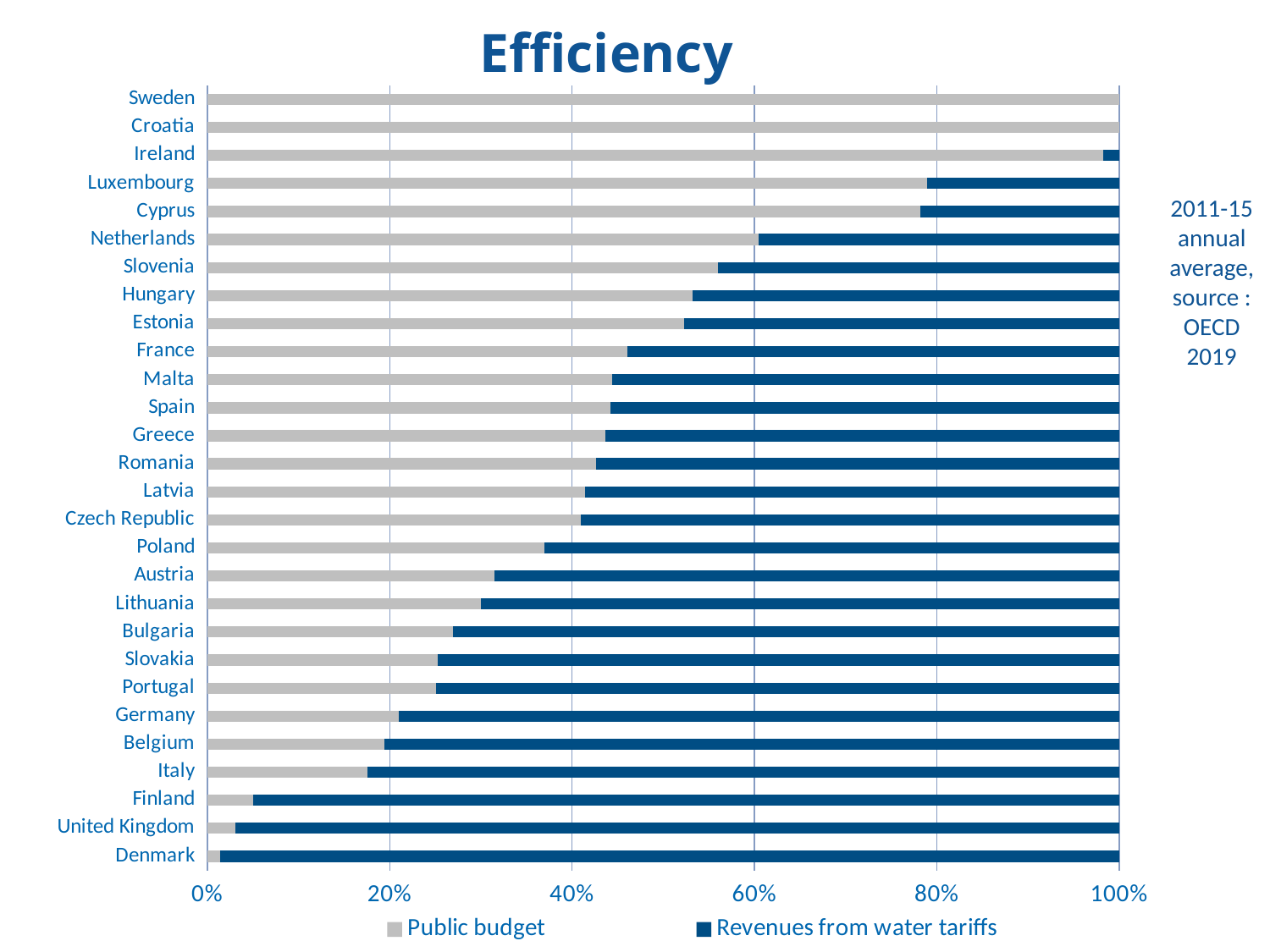
Which has the larger Public budget share, Netherlands or Slovenia? Netherlands How many countries are listed on the chart? 28 Which colour represents Public budget in the chart? Grey Is the Public budget share for Poland greater or less than 40%? less What kind of chart is shown on the slide? Stacked bar chart Is the Public budget share for Finland greater or less than 20%? less Is the Public budget share for Slovenia greater or less than 40%? greater How many series does the legend list? 2 What is the title of the chart? Efficiency Which has the larger Revenues from water tariffs share, Italy or Germany? Italy What is the Public budget share for Sweden? 100%